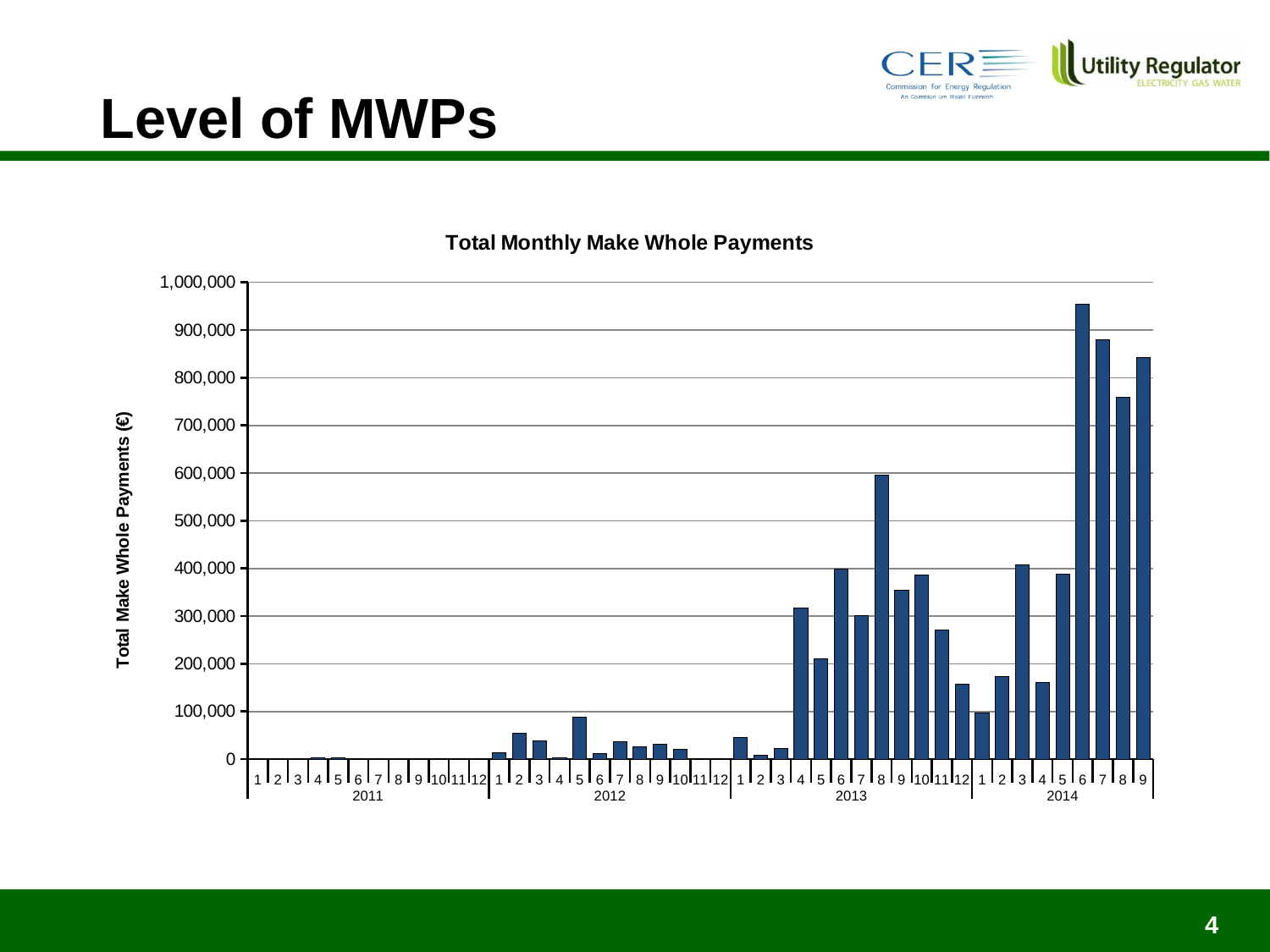
What is the label on the vertical axis of the chart? Total Make Whole Payments (€) Is the value for month 8 of 2013 greater or less than 500,000? greater Is the value for month 6 of 2014 greater or less than 900,000? greater Which is larger, the value for month 4 of 2013 or the value for month 5 of 2013? month 4 of 2013 Is the value for month 8 of 2014 greater or less than 700,000? greater What kind of chart is shown on the slide? bar chart What is the title of the chart? Total Monthly Make Whole Payments Which is larger, the value for month 6 of 2014 or the value for month 8 of 2013? month 6 of 2014 Which month has the highest total make whole payments? June 2014 (month 6 of 2014) How many monthly bars are plotted in the chart? 45 Do the total monthly make whole payments generally rise or fall from 2011 to 2014? rise